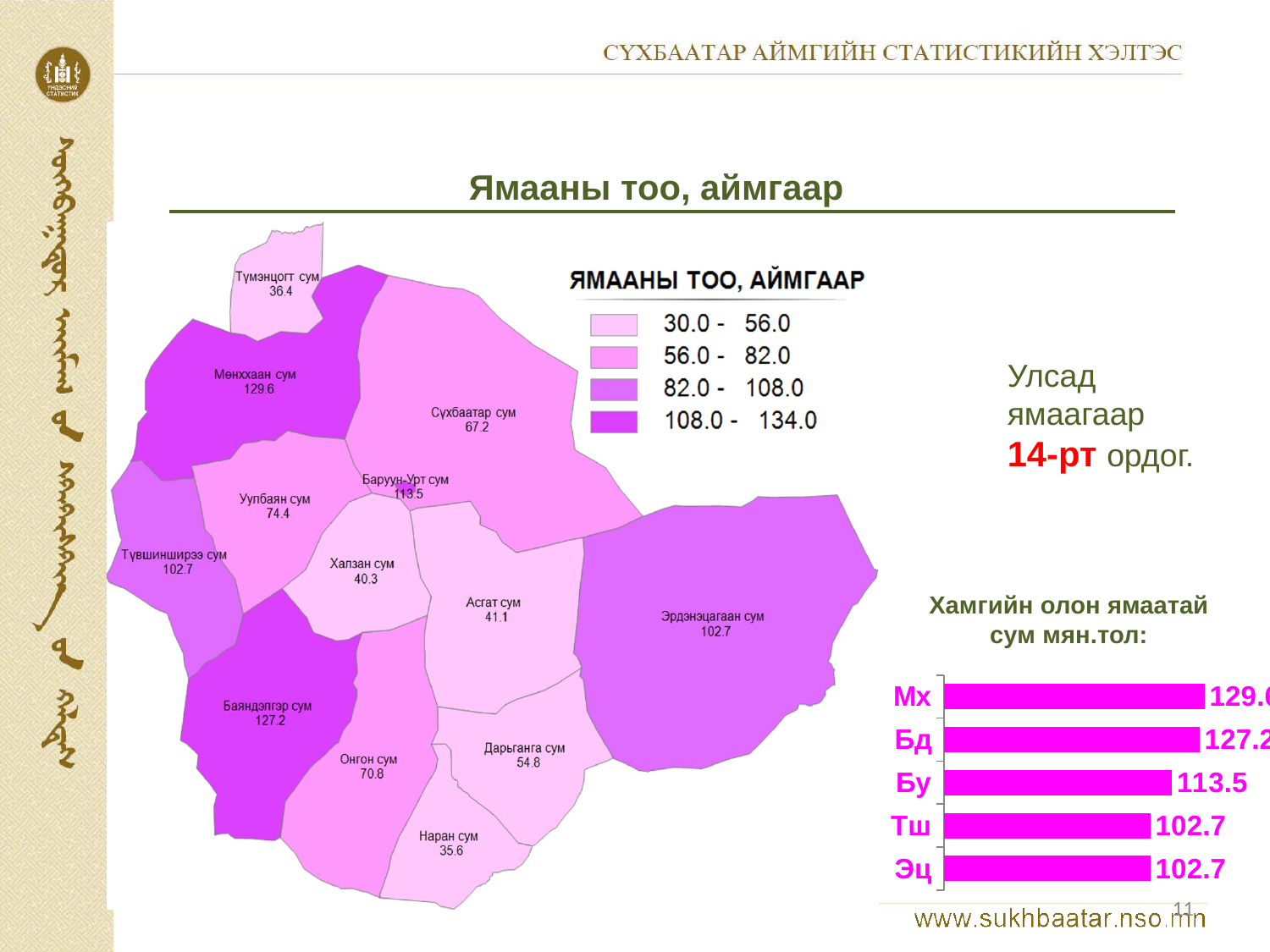
In the bar chart 'Хамгийн олон ямаатай сум мян.тол:', which is larger, the value for Бу or the value for Эц? Бу How many value ranges does the legend of the map 'ЯМААНЫ ТОО, АЙМГААР' list? 4 What kind of chart is the chart titled 'Хамгийн олон ямаатай сум мян.тол:' on the right of the slide? bar chart In the bar chart 'Хамгийн олон ямаатай сум мян.тол:', how many categories are shown? 5 On the map 'ЯМААНЫ ТОО, АЙМГААР', what is the value shown for Мөнххаан сум? 129.6 On the map 'ЯМААНЫ ТОО, АЙМГААР', which sum has the lowest value? Наран сум In the bar chart 'Хамгийн олон ямаатай сум мян.тол:', what is the difference between the values for Бу and Тш? 10.8 On the map 'ЯМААНЫ ТОО, АЙМГААР', what is the value shown for Баяндэлгэр сум? 127.2 In the bar chart 'Хамгийн олон ямаатай сум мян.тол:', which category has the highest value? Мх In the bar chart 'Хамгийн олон ямаатай сум мян.тол:', what is the value for Эц? 102.7 In the bar chart 'Хамгийн олон ямаатай сум мян.тол:', what is the value for Тш? 102.7 In the bar chart 'Хамгийн олон ямаатай сум мян.тол:', what is the value for Бу? 113.5